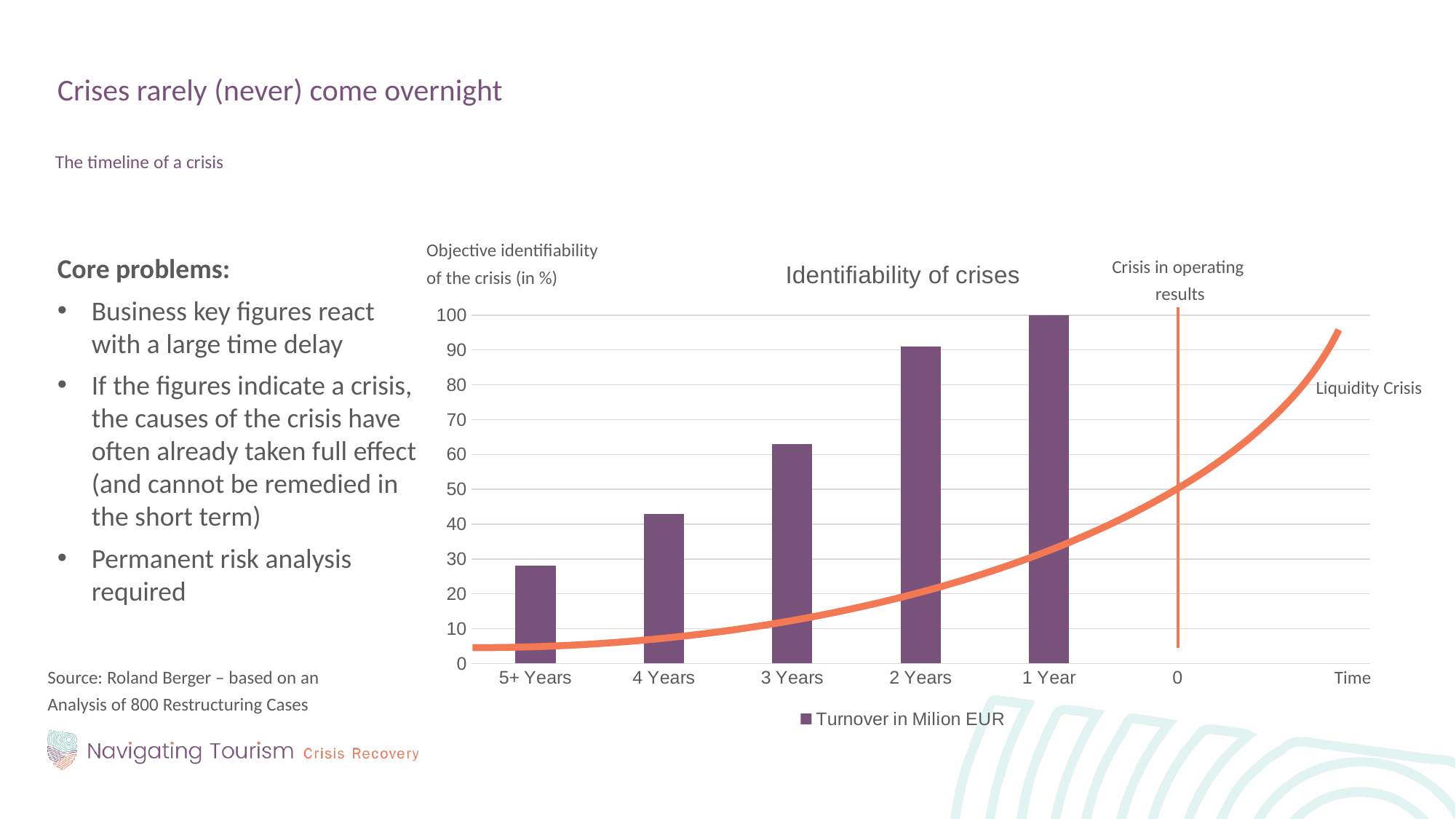
Is the value for 3 Years greater or less than 60? greater Is the value for 5+ Years greater or less than 30? less Do the bar values rise or fall from 5+ Years to 1 Year? rise What is the value of the bar for 1 Year? 100 What kind of chart is shown on the slide? bar chart What is the title of the chart? Identifiability of crises How many bars are plotted in the chart? 5 How many series does the legend list? 1 Which is larger, the bar for 4 Years or the bar for 3 Years? 3 Years Which category has the lowest bar? 5+ Years Which category has the highest bar? 1 Year